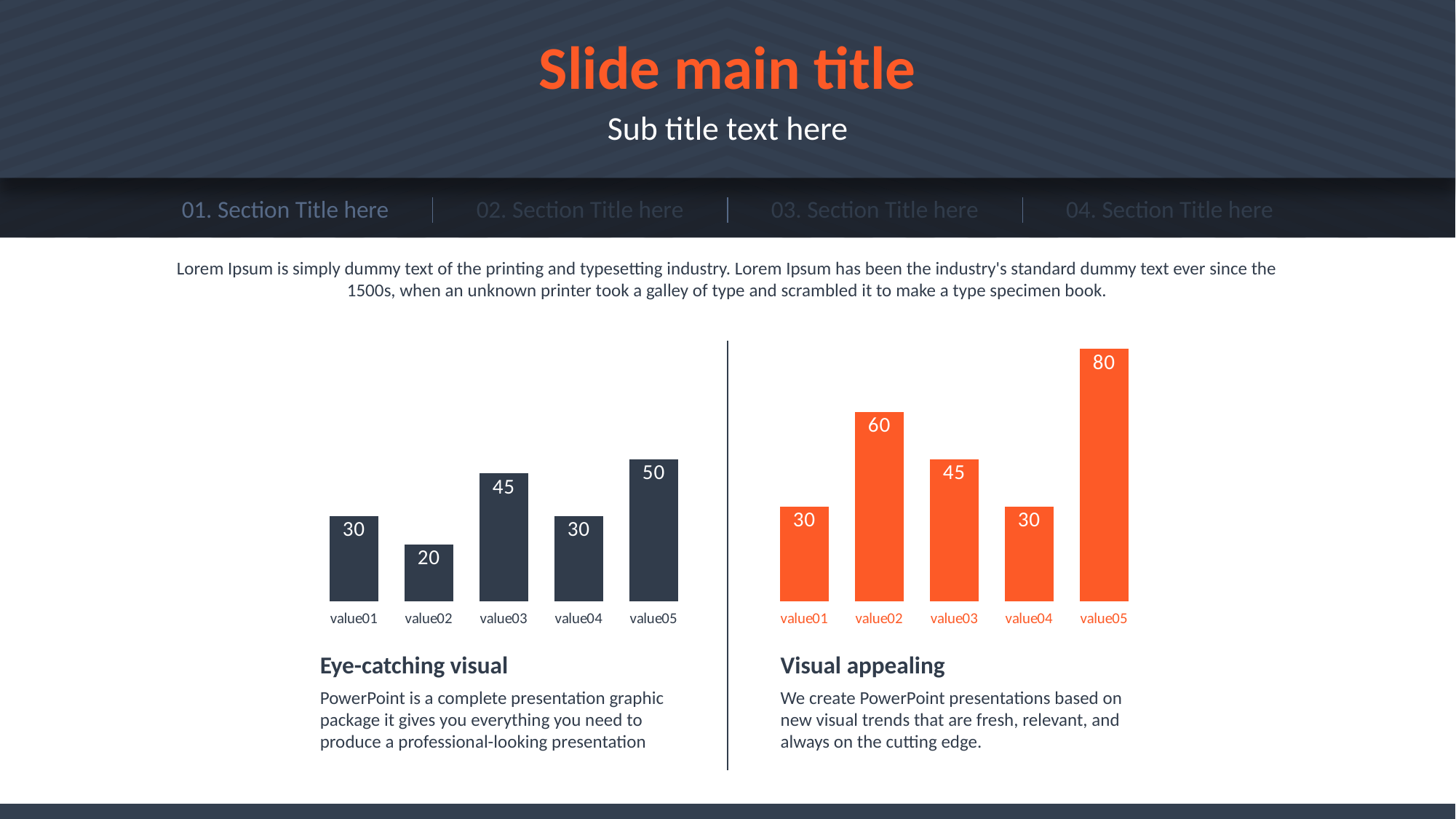
In the right chart, which category has the highest value? value05 In the left chart, what is the value for value01? 30 What kind of chart is the right chart? bar chart In the left chart, what is the difference between value05 and value02? 30 In the left chart, which category has the lowest value? value02 In the left chart, what is the value for value03? 45 In the left chart, which category has the highest value? value05 In the right chart, what is the difference between value05 and value02? 20 What colour are the bars in the right chart? orange In the right chart, what is the value for value02? 60 In the right chart, which is larger, value02 or value03? value02 How many bars are in the left chart? 5